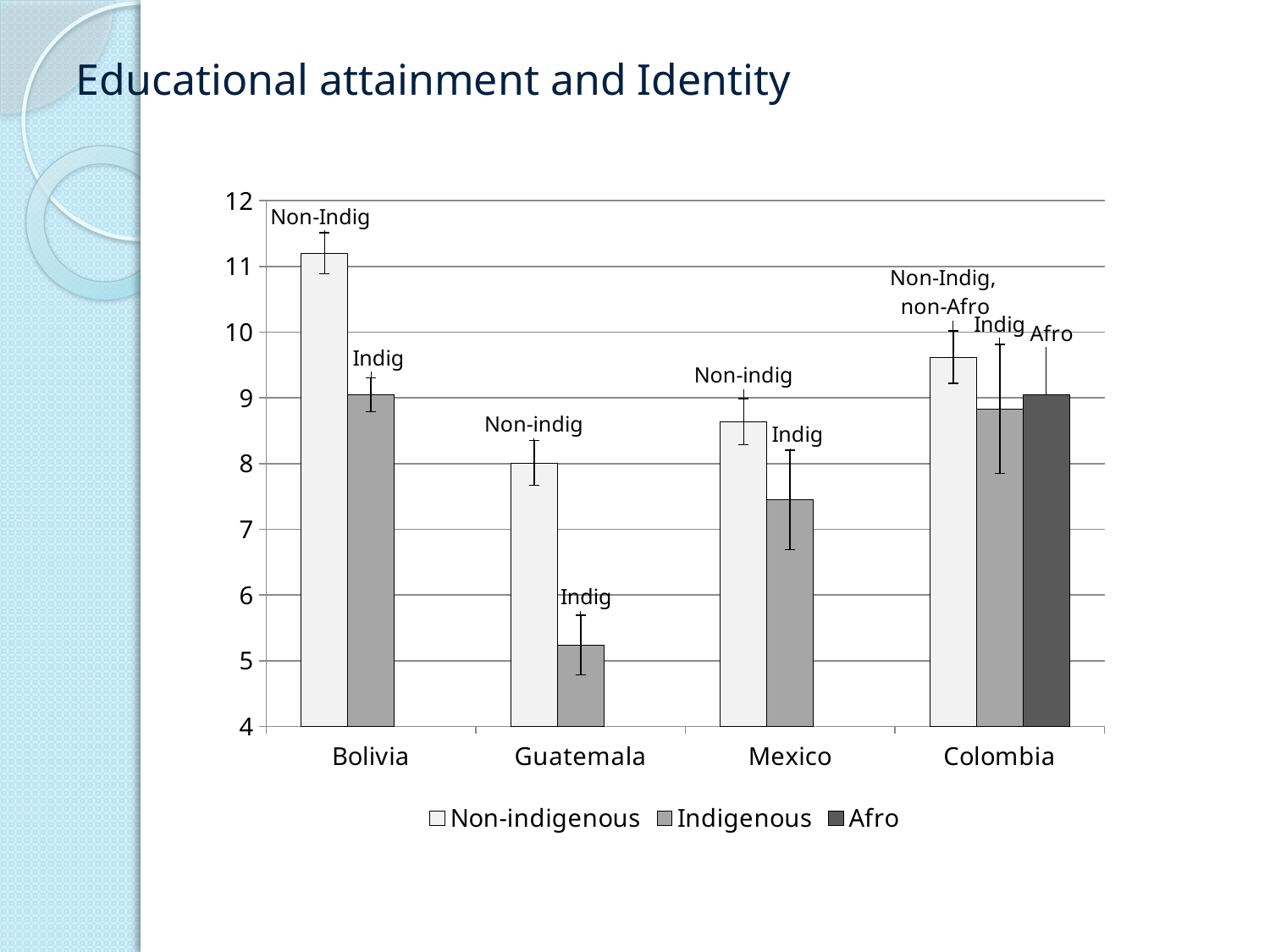
Is the Indigenous value for Guatemala greater or less than 6? less Is the Indigenous value for Mexico greater or less than 8? less In Mexico, which is larger: the Non-indigenous bar or the Indigenous bar? Non-indigenous What kind of chart is shown on the slide? bar chart Is the Non-indigenous value for Bolivia greater or less than 11? greater Which country has the highest Non-indigenous bar? Bolivia How many series does the chart legend list? 3 Which country has the lowest Non-indigenous bar? Guatemala Which country has the lowest Indigenous bar? Guatemala Which country is the only one with an Afro bar in the chart? Colombia How many countries are shown on the x axis of the chart? 4